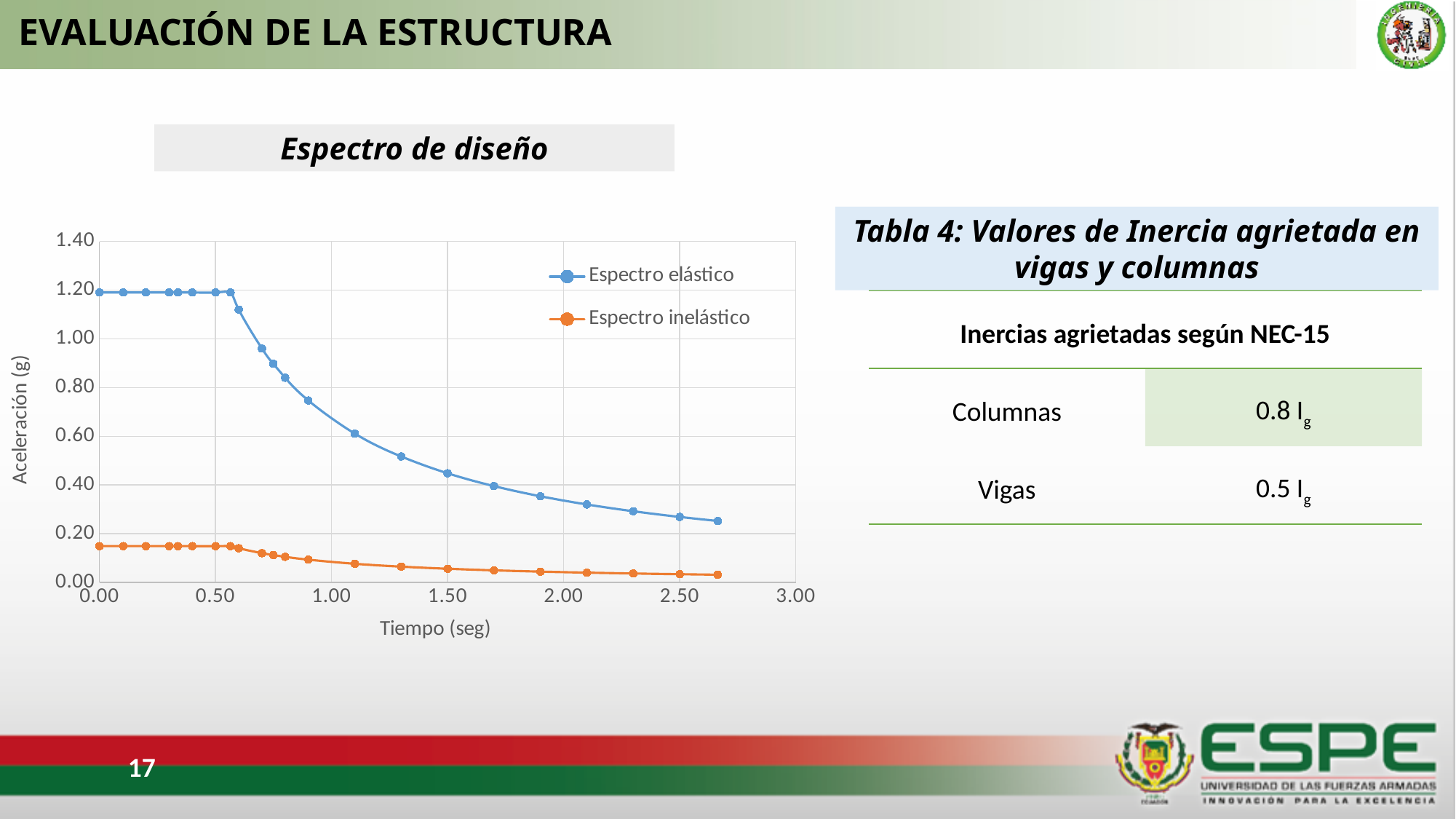
What kind of chart is the 'Espectro de diseño' chart? line chart In the 'Espectro de diseño' chart, is the value of Espectro inelástico at 0.00 seconds greater or less than 0.20? less What are the two series named in the legend of the 'Espectro de diseño' chart? Espectro elástico and Espectro inelástico What is the label of the vertical axis of the 'Espectro de diseño' chart? Aceleración (g) In the 'Espectro de diseño' chart, is the value of Espectro elástico at 1.50 seconds greater or less than 0.40? greater In the 'Espectro de diseño' chart, is the value of Espectro elástico at 0.00 seconds greater or less than 1.00? greater In the 'Espectro de diseño' chart, does the Espectro elástico series rise or fall as time increases beyond 0.50 seconds? fall How many series does the legend of the 'Espectro de diseño' chart list? 2 In the 'Espectro de diseño' chart, does the Espectro inelástico series rise or fall between 1.00 and 2.50 seconds? fall In the 'Espectro de diseño' chart, which series has the larger value at 1.00 seconds, Espectro elástico or Espectro inelástico? Espectro elástico In the 'Espectro de diseño' chart, which series lies higher across the whole time range? Espectro elástico